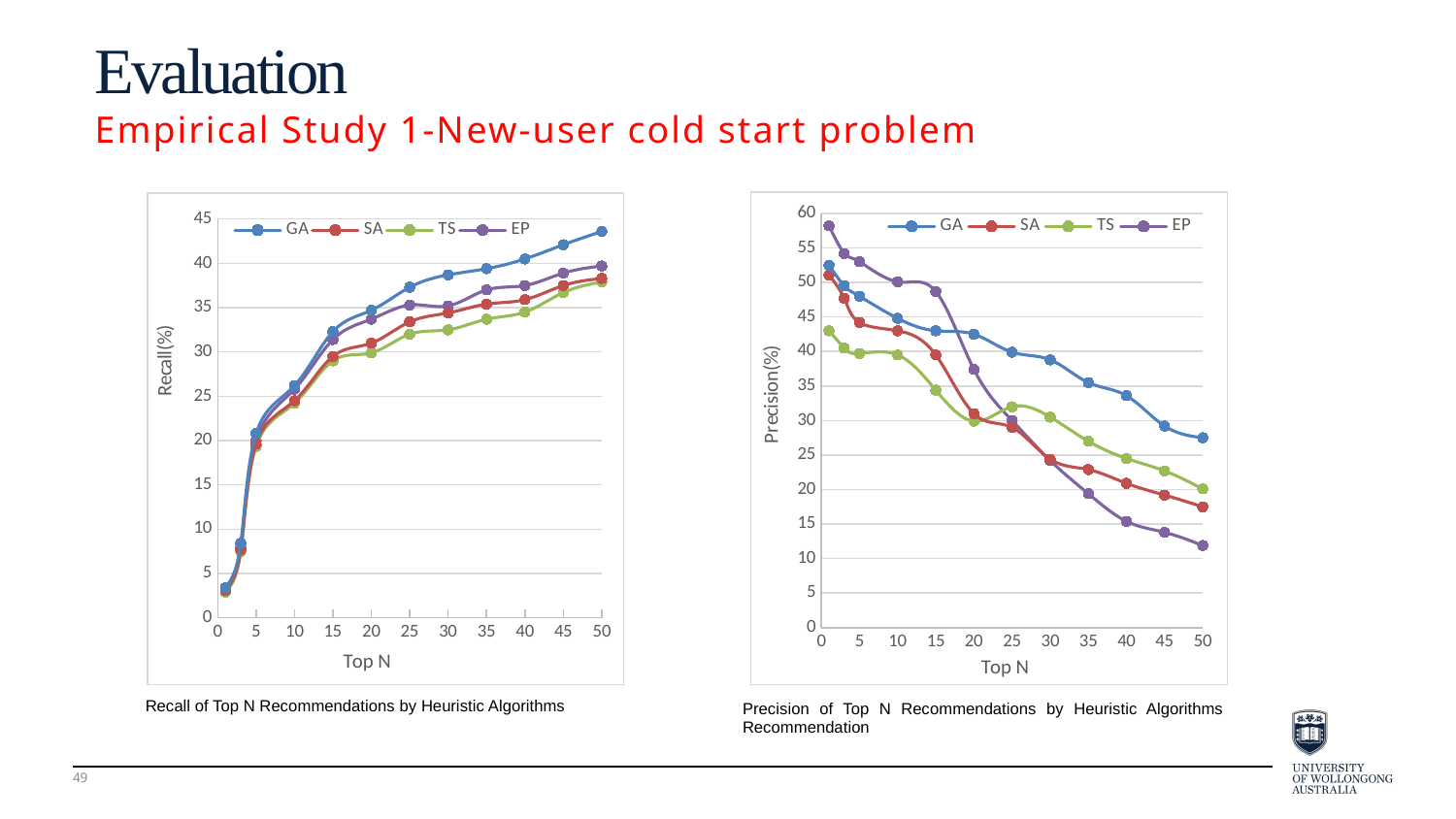
In the right Precision chart, at Top N = 50, which is larger: the precision for GA or for EP? GA In the right Precision chart, which series has the highest precision at Top N = 1? EP In the left Recall chart, which series has the highest recall at Top N = 50? GA What kind of chart is the left chart titled 'Recall of Top N Recommendations by Heuristic Algorithms'? line chart In the left Recall chart, do the values rise or fall as Top N increases? rise In the right Precision chart, do the values rise or fall as Top N increases? fall Which series are listed in the legend of the right Precision chart? GA, SA, TS, EP What kind of chart is the right chart titled 'Precision of Top N Recommendations by Heuristic Algorithms'? line chart In the right Precision chart, which series has the lowest precision at Top N = 50? EP In the right Precision chart, is the precision for EP at Top N = 50 greater or less than 15? less In the left Recall chart, is the recall for GA at Top N = 50 greater or less than 40? greater How many series does the legend of the left Recall chart list? 4